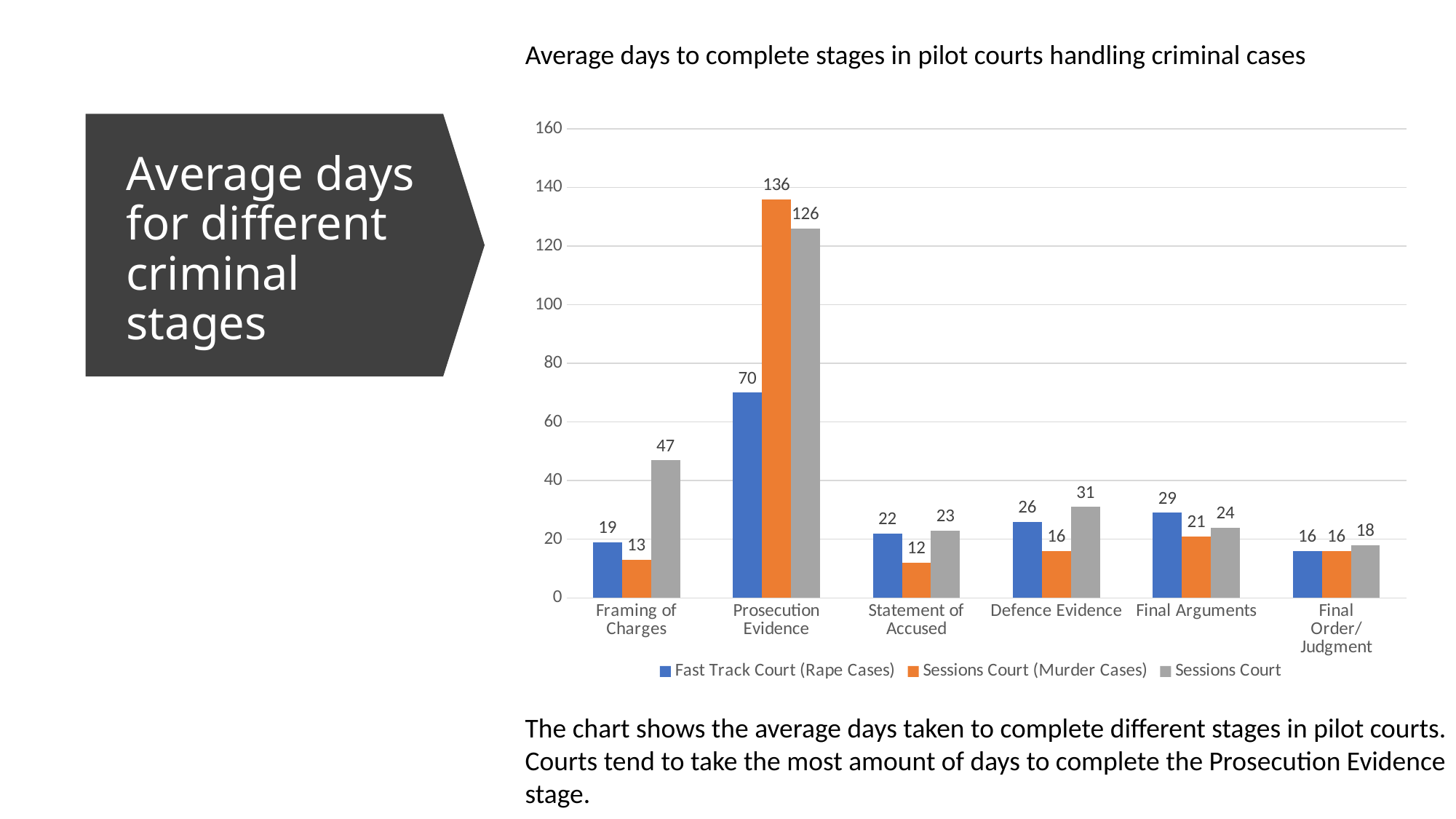
How many stages are shown on the x axis? 6 Which stage has the highest value for Fast Track Court (Rape Cases)? Prosecution Evidence What kind of chart is shown on the slide? Bar chart Which is larger at the Framing of Charges stage: Fast Track Court (Rape Cases) or Sessions Court? Sessions Court Is the value for Sessions Court at the Prosecution Evidence stage greater or less than 120? greater How many series does the legend list? 3 What is the value for Sessions Court (Murder Cases) at the Prosecution Evidence stage? 136 Which stage has the lowest value for Sessions Court (Murder Cases)? Statement of Accused What is the value for Fast Track Court (Rape Cases) at the Framing of Charges stage? 19 What is the title of the chart? Average days to complete stages in pilot courts handling criminal cases What is the difference between the Sessions Court (Murder Cases) and Fast Track Court (Rape Cases) values at the Prosecution Evidence stage? 66 What is the value for Sessions Court at the Defence Evidence stage? 31